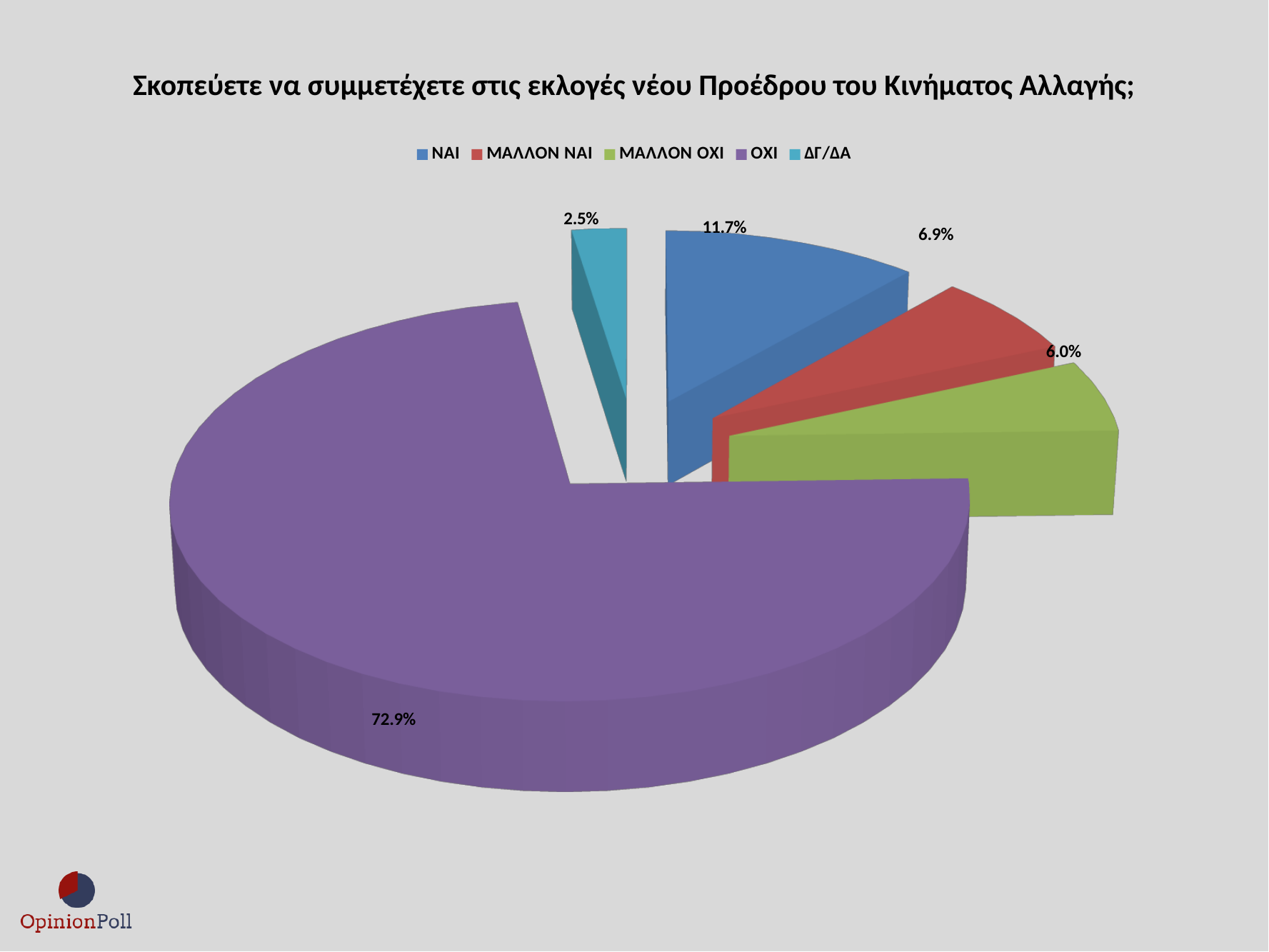
What is the value for ΝΑΙ? 11.7% Which category has the largest share of the pie? ΟΧΙ What is the value for ΟΧΙ? 72.9% What is the difference between the values for ΟΧΙ and ΝΑΙ? 61.2% What colour is the ΟΧΙ slice? purple Which category has the smallest share of the pie? ΔΓ/ΔΑ Which is larger, the value for ΜΑΛΛΟΝ ΝΑΙ or the value for ΜΑΛΛΟΝ ΟΧΙ? ΜΑΛΛΟΝ ΝΑΙ How many categories does the legend list? 5 What is the value for ΜΑΛΛΟΝ ΟΧΙ? 6.0% What kind of chart is shown on the slide? pie chart What is the value for ΔΓ/ΔΑ? 2.5% What is the value for ΜΑΛΛΟΝ ΝΑΙ? 6.9%